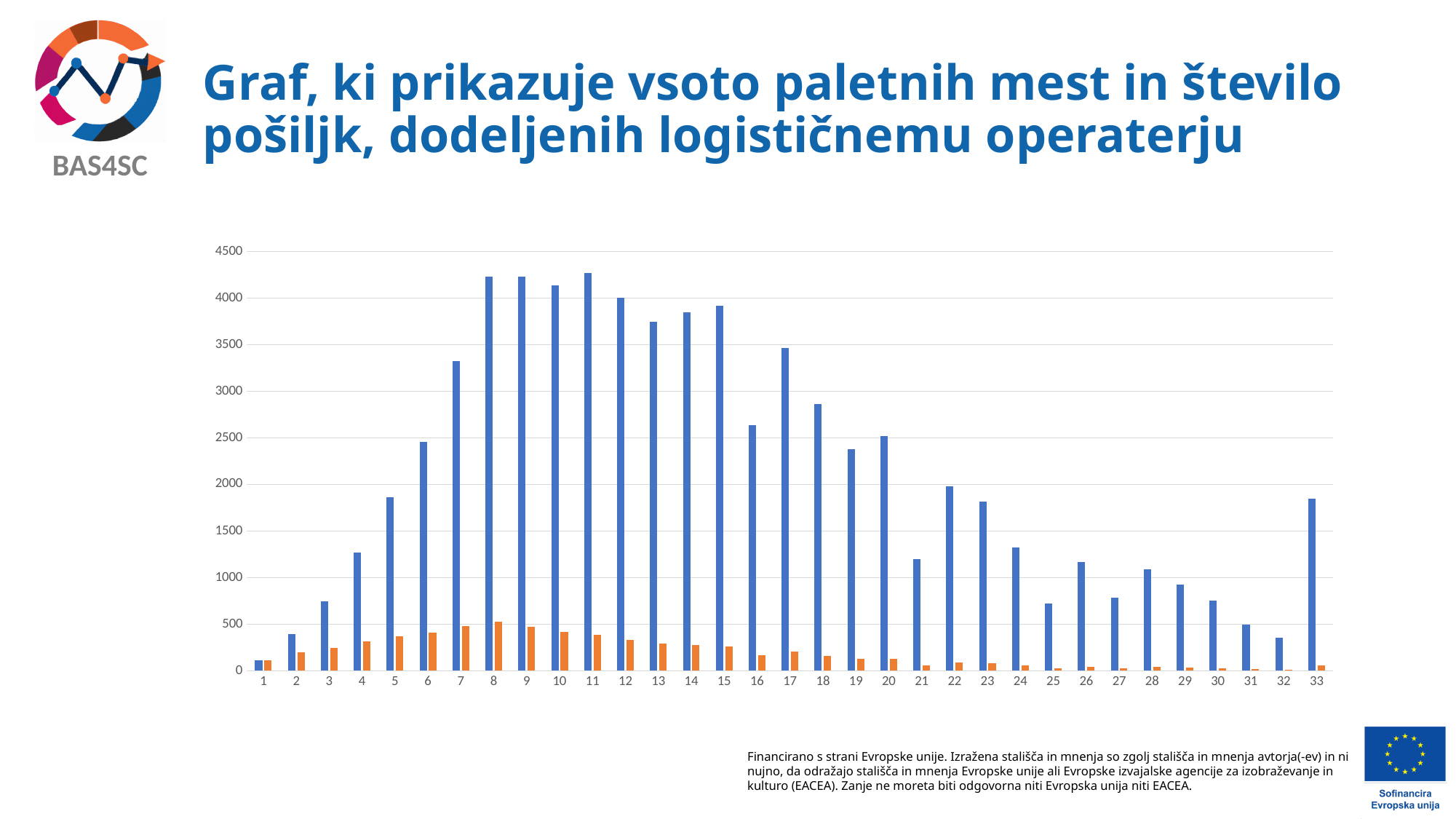
Is the value of the blue bar for category 21 greater or less than 1500? less How many differently coloured bar series are plotted in the chart? 2 Which category has the lowest blue bar? 1 Is the value of the blue bar for category 1 greater or less than 500? less Is the value of the blue bar for category 11 greater or less than 4000? greater Which category has the highest orange bar? 8 Which blue bar is taller, category 5 or category 6? 6 How many categories are shown along the x axis of the chart? 33 What kind of chart is shown on the slide? bar chart Do the blue bars rise or fall from category 11 to category 21? fall